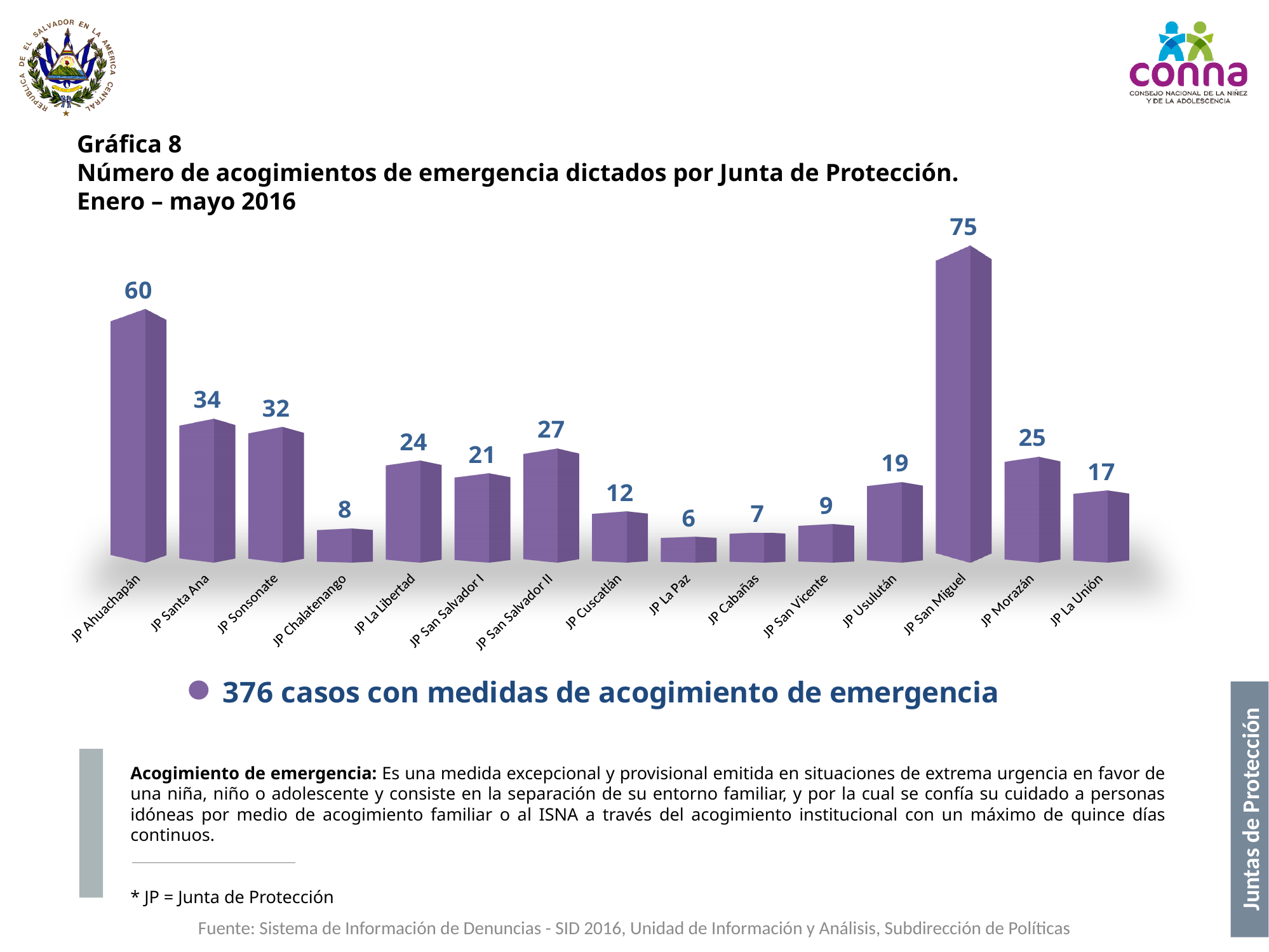
What is the difference between the values for JP Santa Ana and JP Sonsonate? 2 Which Junta de Protección has the lowest number of acogimientos de emergencia? JP La Paz Which is larger, the value for JP La Libertad or the value for JP San Salvador II? JP San Salvador II What period does the chart title say the data covers? Enero – mayo 2016 What is the value for JP Chalatenango? 8 What is the total number of cases with emergency shelter measures stated on the slide? 376 What kind of chart is shown on the slide? Bar chart What is the value for JP San Miguel? 75 How many Juntas de Protección are shown on the x axis? 15 Which Junta de Protección has the highest number of acogimientos de emergencia? JP San Miguel What is the difference between the values for JP San Miguel and JP Ahuachapán? 15 What is the value for JP Morazán? 25